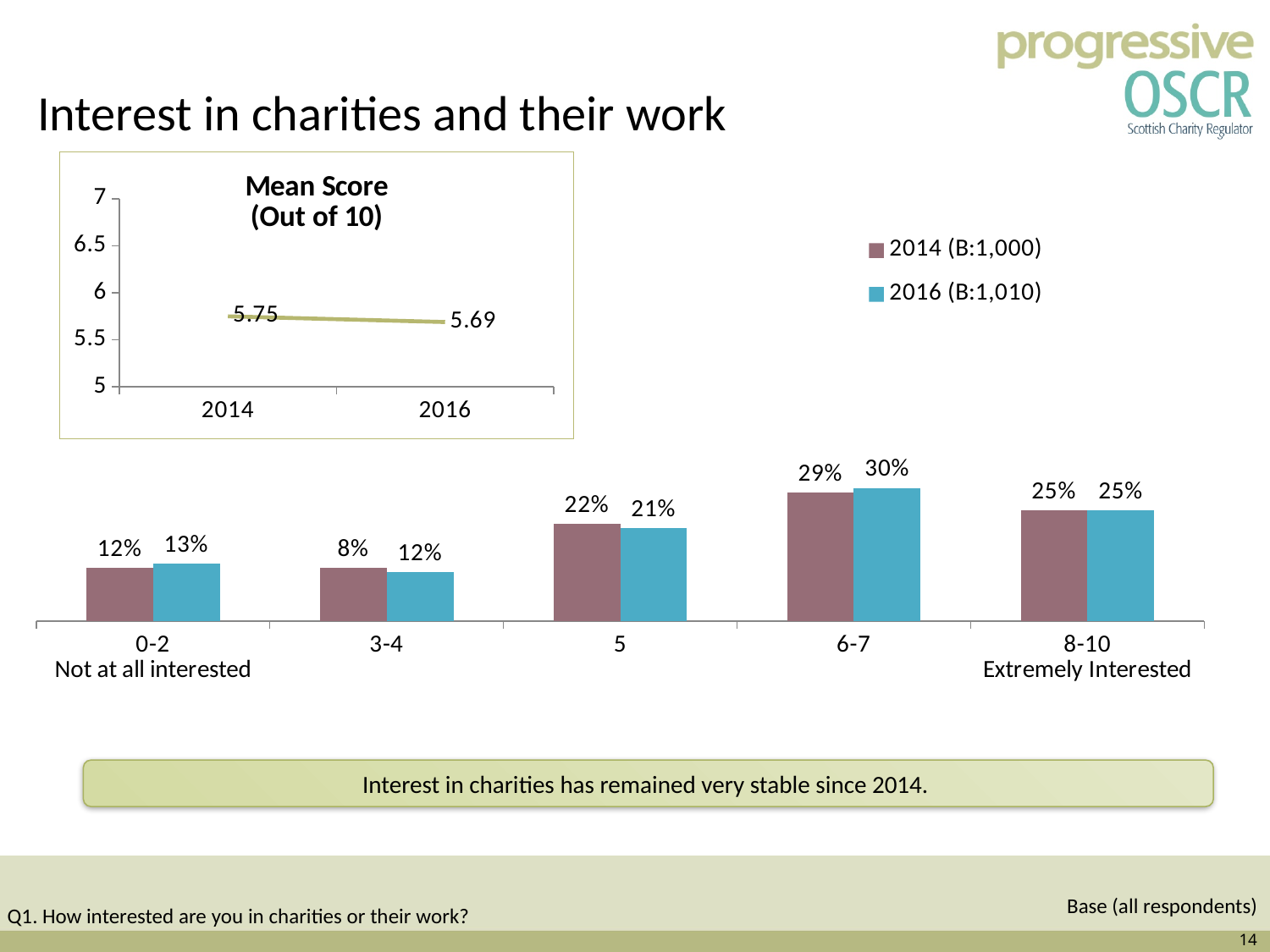
In the bar chart at the bottom, what percentage of respondents gave a score of 3-4 in 2016? 12% How many series does the legend of the bar chart at the bottom list? 2 In the Mean Score (Out of 10) chart, what is the mean score for 2014? 5.75 In the bar chart at the bottom, which score category has the lowest value for 2014? 3-4 In the Mean Score (Out of 10) chart, does the mean score rise or fall from 2014 to 2016? fall What kind of chart is the Mean Score (Out of 10) chart? line chart In the bar chart at the bottom, which score category has the highest value for 2016? 6-7 In the bar chart at the bottom, is the 2014 value for the 5 category larger or smaller than the 2016 value? larger In the bar chart at the bottom, what percentage of respondents gave a score of 6-7 in 2014? 29% In the bar chart at the bottom, what is the difference between the 2016 and 2014 values for the 3-4 category? 4 percentage points In the Mean Score (Out of 10) chart, what is the mean score for 2016? 5.69 How many score categories are shown on the x axis of the bar chart at the bottom? 5